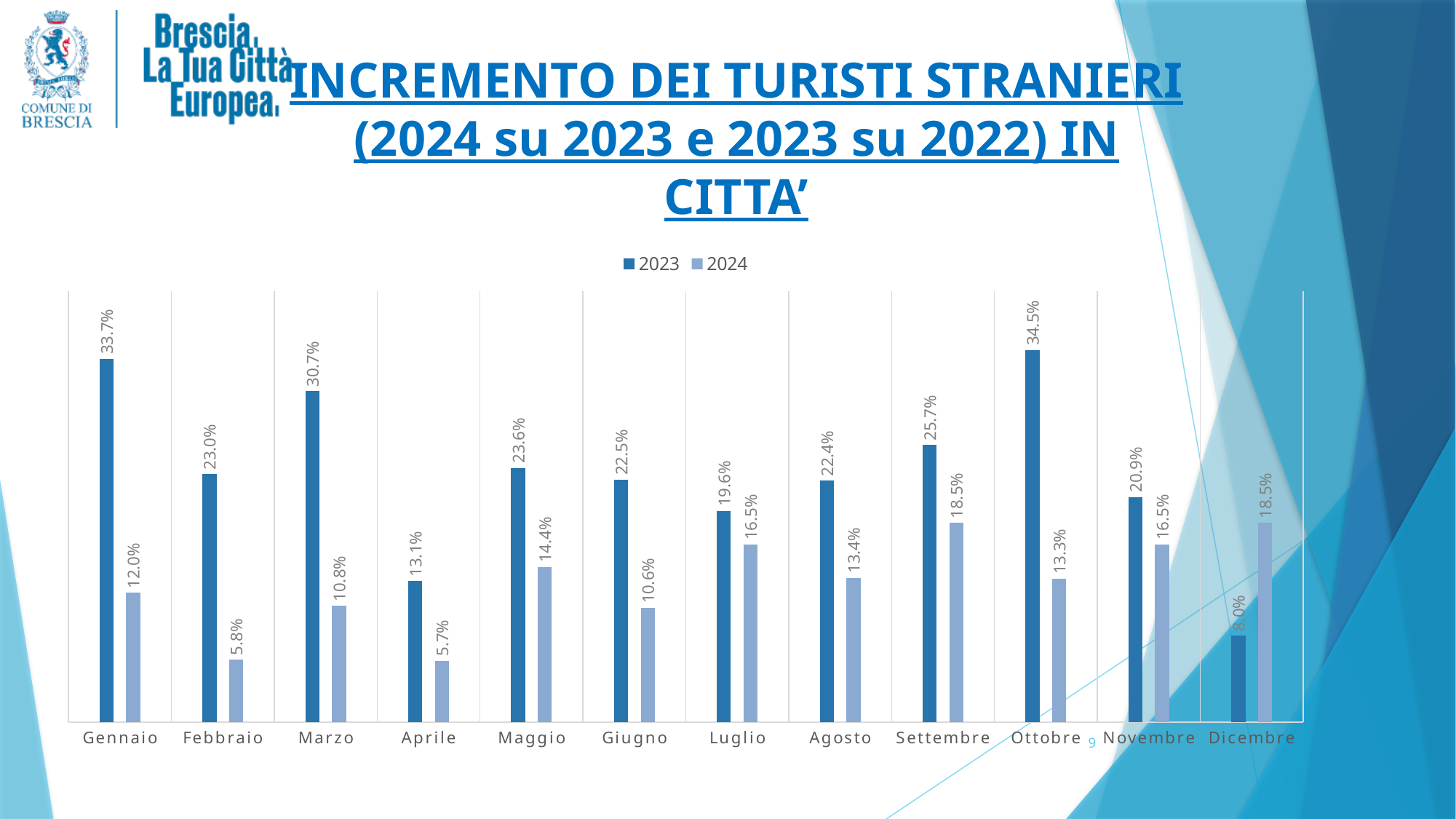
What kind of chart is shown on the slide? Bar chart Which is larger, the 2023 value for Gennaio or the 2023 value for Marzo? Gennaio Which is larger for Dicembre, the 2023 value or the 2024 value? 2024 What is the 2023 value for Gennaio? 33.7% Which month has the highest 2023 value? Ottobre What is the 2023 value for Luglio? 19.6% What is the 2024 value for Aprile? 5.7% How many series does the legend list? 2 How many months are shown on the x axis? 12 Which month has the lowest 2023 value? Dicembre What is the difference between the 2023 and 2024 values for Gennaio? 21.7 percentage points What is the 2024 value for Settembre? 18.5%